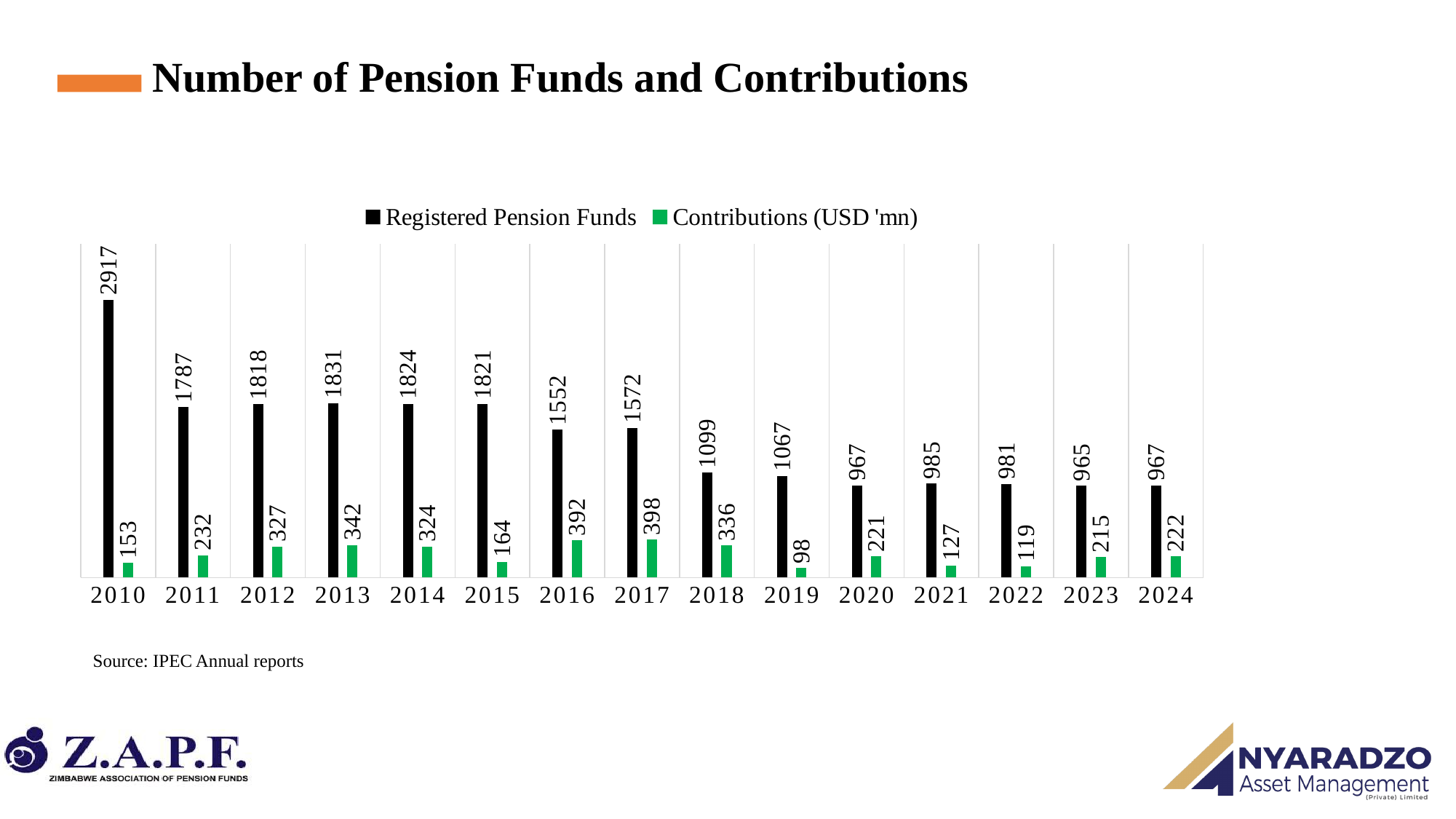
Which year has the lowest Contributions (USD 'mn)? 2019 What is the value of Contributions (USD 'mn) in 2017? 398 What is the difference in Registered Pension Funds between 2010 and 2011? 1130 What is the number of Registered Pension Funds in 2024? 967 Which year has more Registered Pension Funds, 2016 or 2018? 2016 Which year has the lowest number of Registered Pension Funds? 2023 What kind of chart is shown on the slide? Bar chart How many series does the legend list? 2 Which year has the highest Contributions (USD 'mn)? 2017 What is the number of Registered Pension Funds in 2010? 2917 What is the difference in Contributions (USD 'mn) between 2017 and 2019? 300 How many years are shown on the x axis? 15